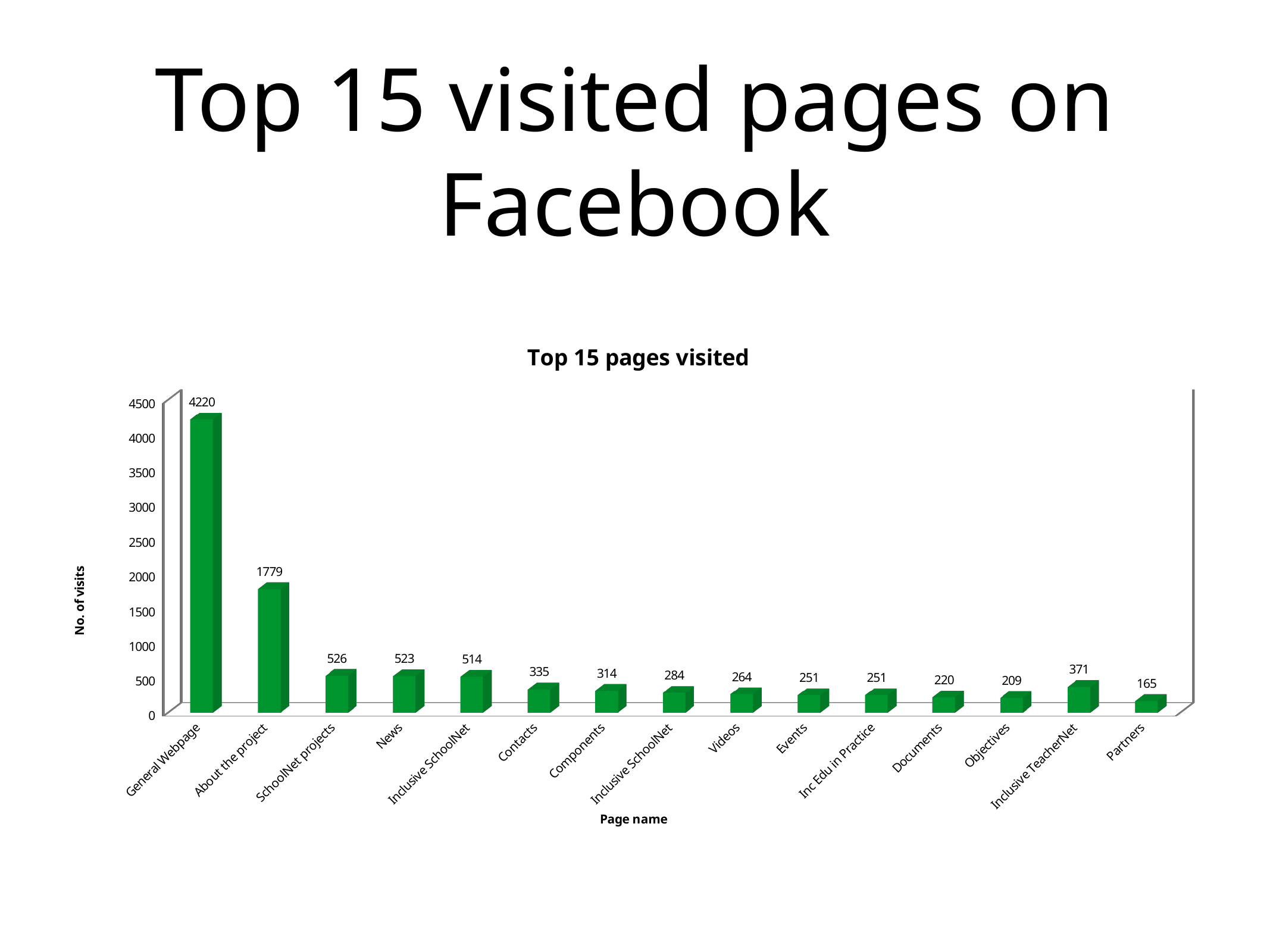
What is the difference in visits between General Webpage and About the project? 2441 What is the difference in visits between SchoolNet projects and News? 3 What is the number of visits for About the project? 1779 What is the title of the chart? Top 15 pages visited Which has more visits, Contacts or Components? Contacts How many pages are shown in the chart? 15 What is the number of visits for Inclusive TeacherNet? 371 Which page has the lowest number of visits? Partners What is the number of visits for Partners? 165 What kind of chart is shown on the slide? Bar chart Which page has the highest number of visits? General Webpage What is the number of visits for General Webpage? 4220